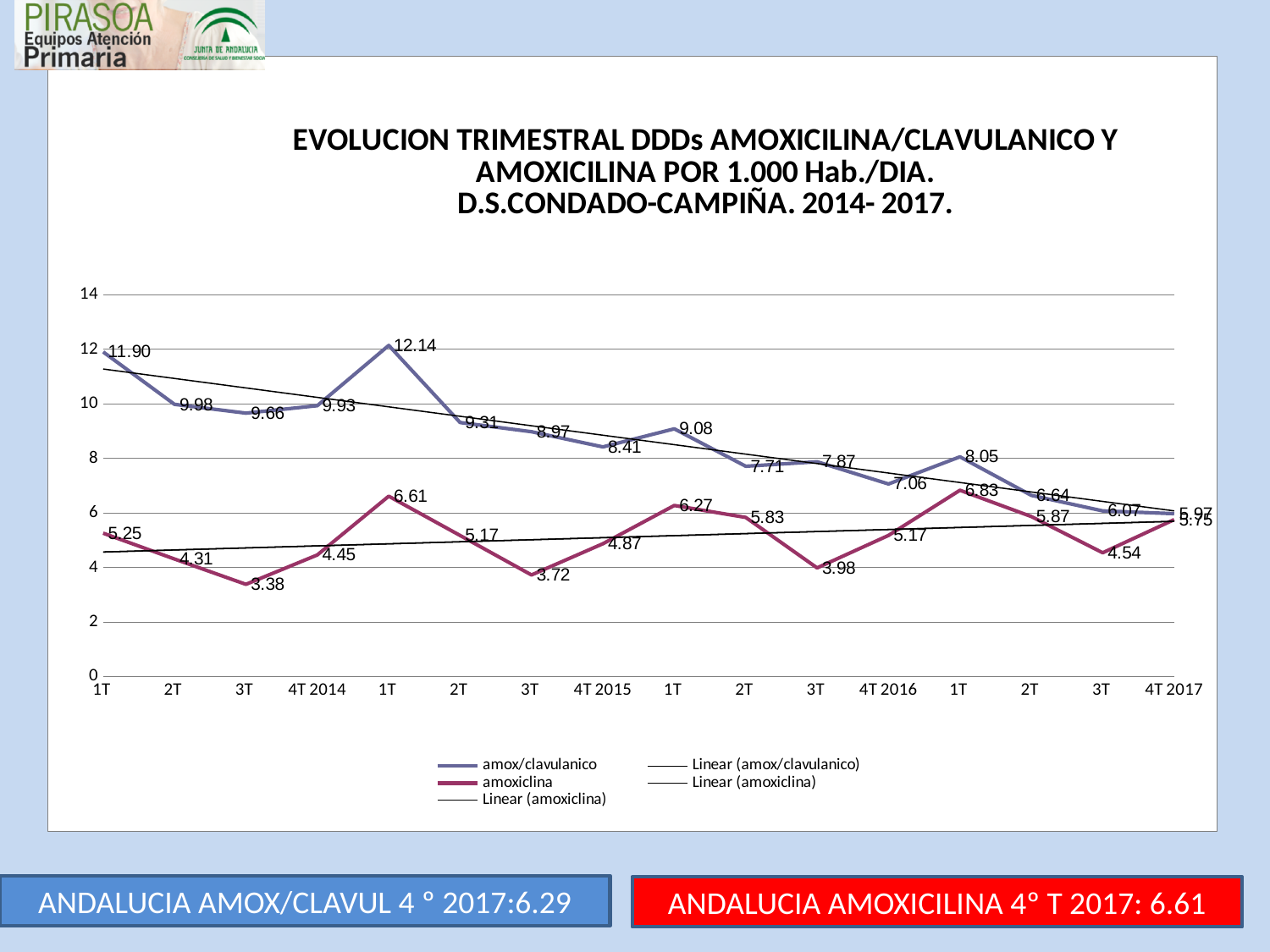
Does the amox/clavulanico series generally rise or fall from 1T 2014 to 4T 2017? fall At 1T of 2015, which series has the larger value, amox/clavulanico or amoxiclina? amox/clavulanico What is the difference between the amox/clavulanico values at 1T 2014 (11.90) and 2T 2014 (9.98)? 1.92 What is the amox/clavulanico value at the first point, 1T of 2014? 11.90 What is the highest value of the amoxiclina series? 6.83 Is the amox/clavulanico value at 3T of 2014 greater or less than 8? greater How many quarterly points are plotted along the x axis? 16 What is the amoxiclina value at 3T of 2014? 3.38 What is the amox/clavulanico value at 1T of 2015 (the point after 4T 2014)? 12.14 What kind of chart is shown on the slide? line chart At which quarter does the amox/clavulanico series reach its highest value? 1T 2015 At which quarter does the amoxiclina series reach its lowest value? 3T 2014